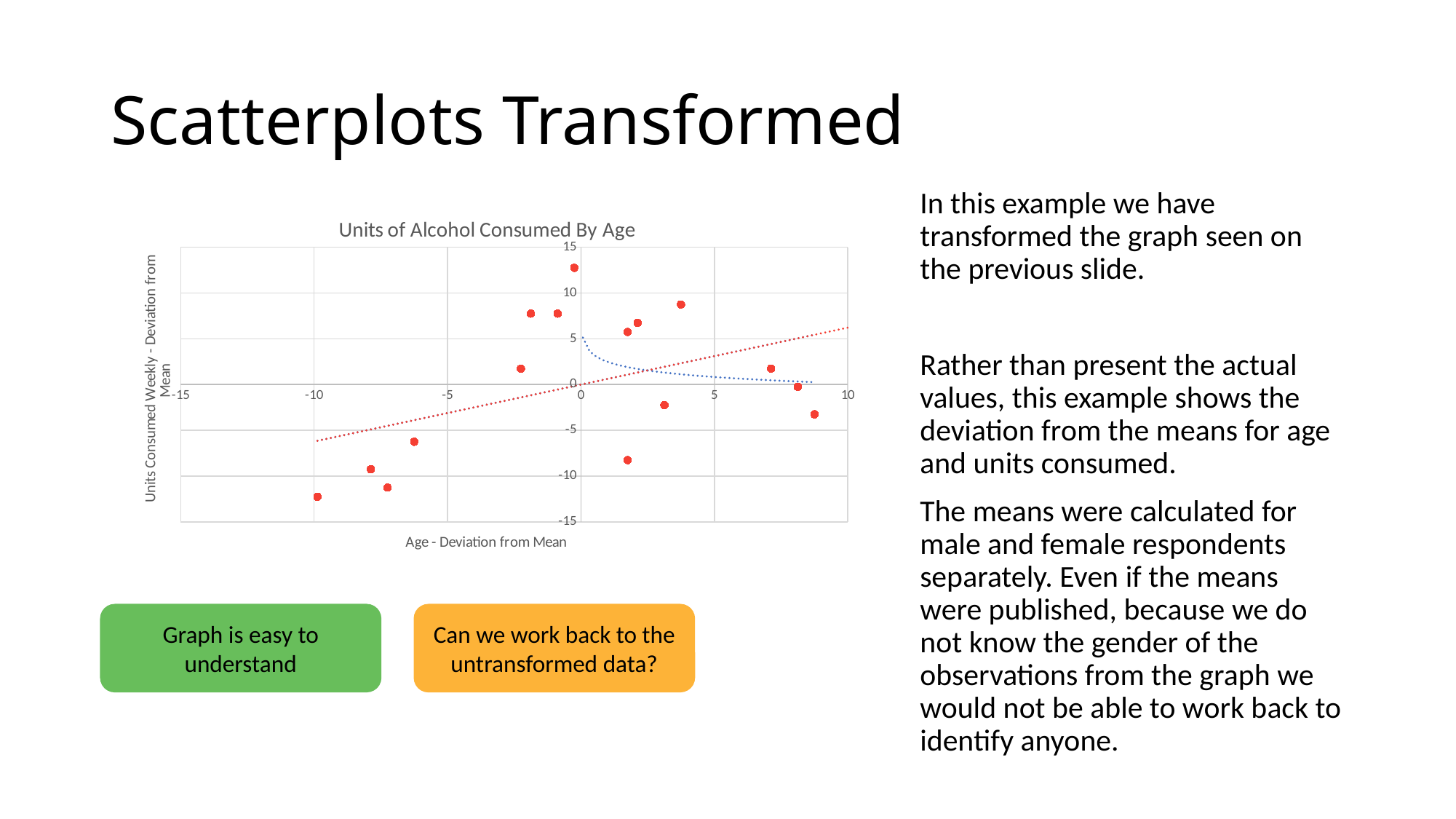
What is the maximum value shown on the y axis? 15 Is the x value of the rightmost plotted point greater or less than 5? greater What is the label of the x axis of the chart? Age - Deviation from Mean Is the x value of the leftmost plotted point greater or less than -5? less Is the lowest plotted point's y value greater or less than -10? less What kind of chart is shown on the slide? Scatter plot Does the red dotted trend line rise or fall as the x value increases? rises Does the blue dotted curve rise or fall as the x value increases? falls What is the title of the chart? Units of Alcohol Consumed By Age